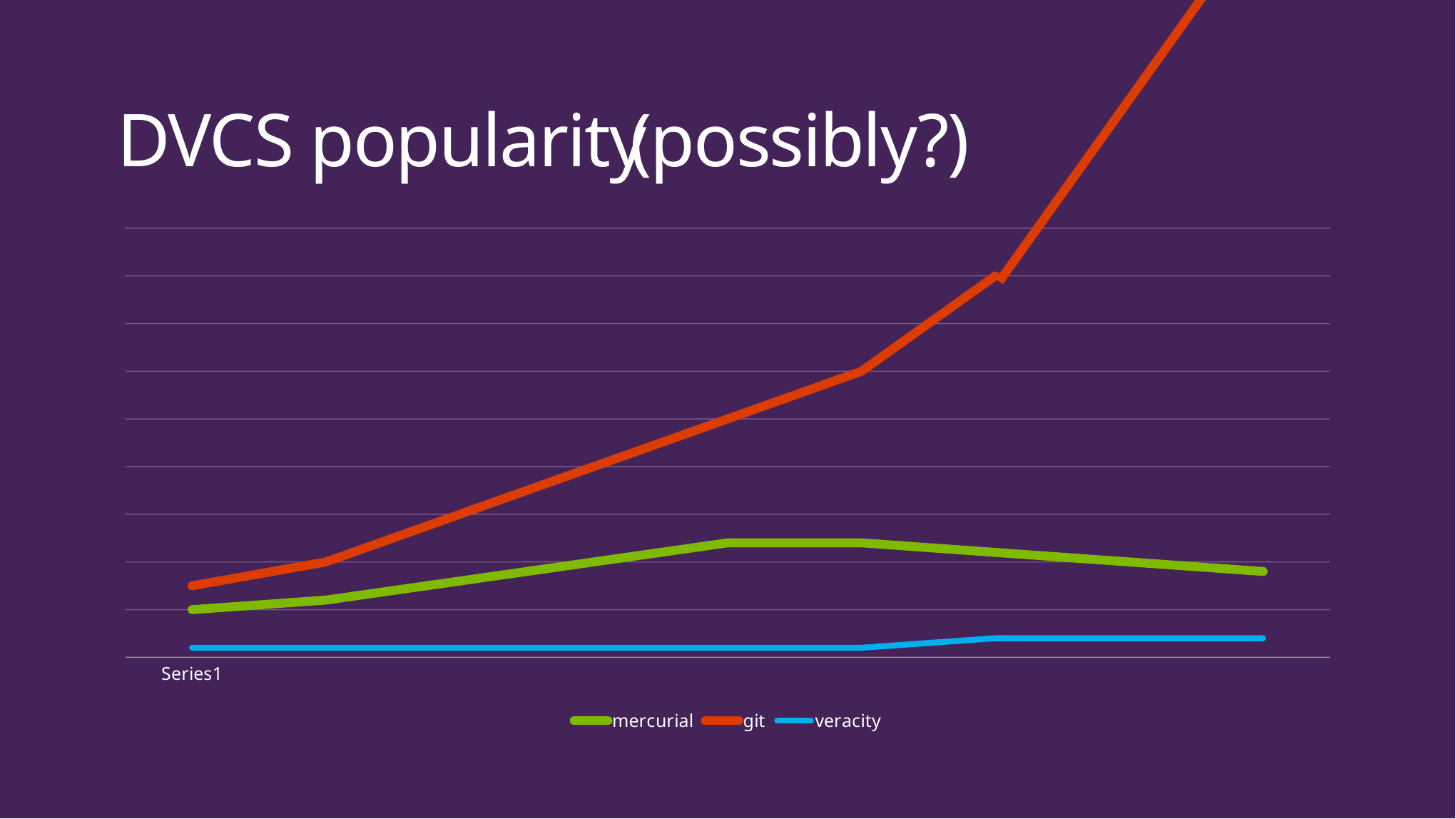
Which series does the legend show in red? git Which series reaches the highest value on the chart? git At the right end of the chart, which is higher, mercurial or veracity? mercurial What kind of chart is shown on the slide? line chart Which series stays lowest across the chart? veracity How many series does the legend list? 3 Which series is plotted in blue? veracity Does the git line rise or fall from left to right? rises Which series does the legend show in green? mercurial Does the mercurial line end higher or lower than its peak in the middle of the chart? lower